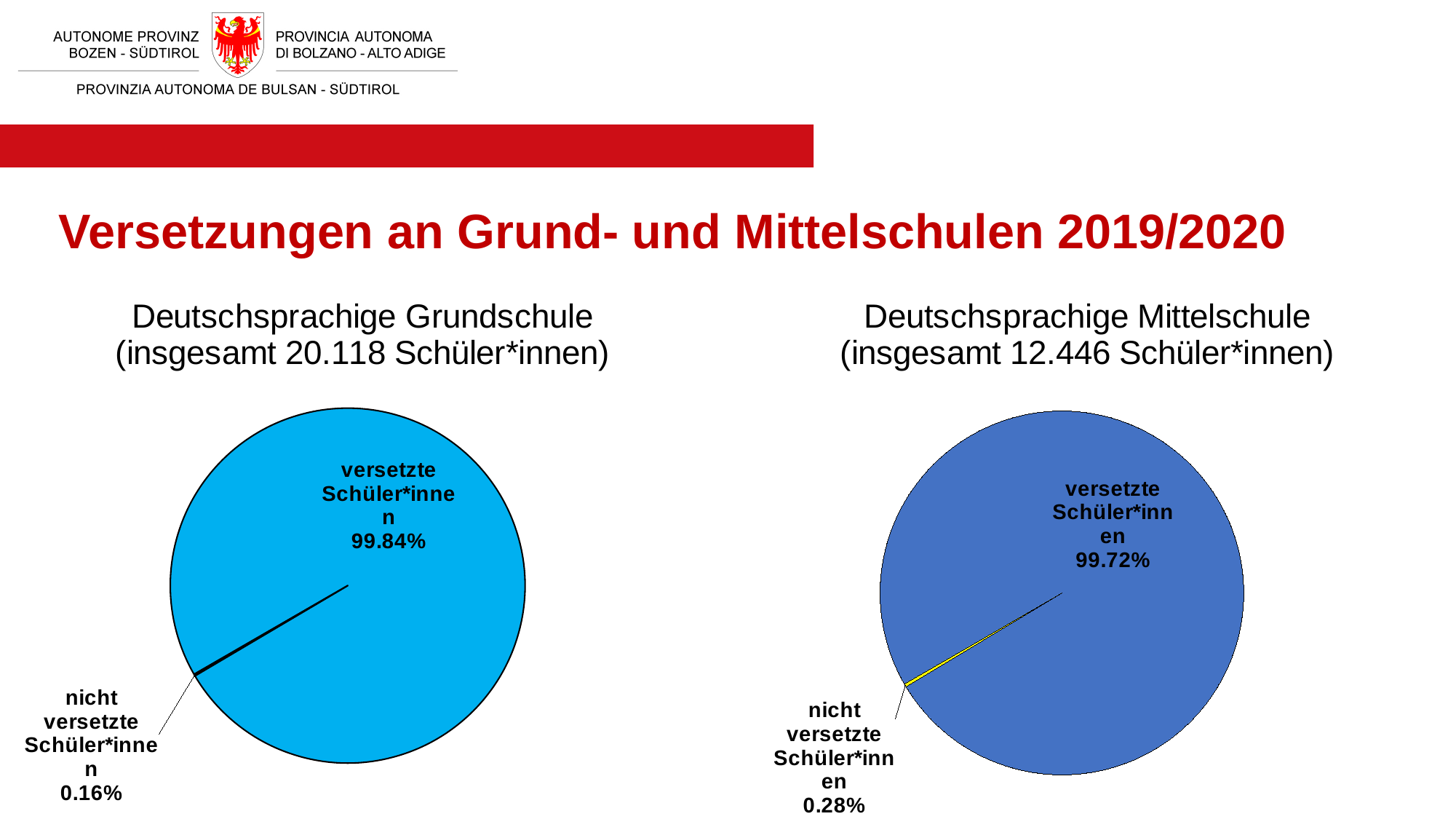
In the Deutschsprachige Grundschule chart, which slice is the largest? versetzte Schüler*innen What is the difference between the 'nicht versetzte Schüler*innen' share in the Deutschsprachige Mittelschule chart and in the Deutschsprachige Grundschule chart? 0.12% In the Deutschsprachige Mittelschule chart, which slice is the smallest? nicht versetzte Schüler*innen What kind of chart is the Deutschsprachige Grundschule chart? Pie chart Which chart shows a larger share of 'nicht versetzte Schüler*innen', the Deutschsprachige Grundschule chart or the Deutschsprachige Mittelschule chart? Deutschsprachige Mittelschule According to the subtitle of the Deutschsprachige Grundschule chart, how many students are included in total? 20.118 How many slices does the Deutschsprachige Mittelschule pie chart have? 2 In the Deutschsprachige Grundschule chart, what share of students is labelled 'versetzte Schüler*innen'? 99.84% According to the subtitle of the Deutschsprachige Mittelschule chart, how many students are included in total? 12.446 In the Deutschsprachige Mittelschule chart, what share of students is labelled 'versetzte Schüler*innen'? 99.72% In the Deutschsprachige Mittelschule chart, what share of students is labelled 'nicht versetzte Schüler*innen'? 0.28% In the Deutschsprachige Grundschule chart, what share of students is labelled 'nicht versetzte Schüler*innen'? 0.16%